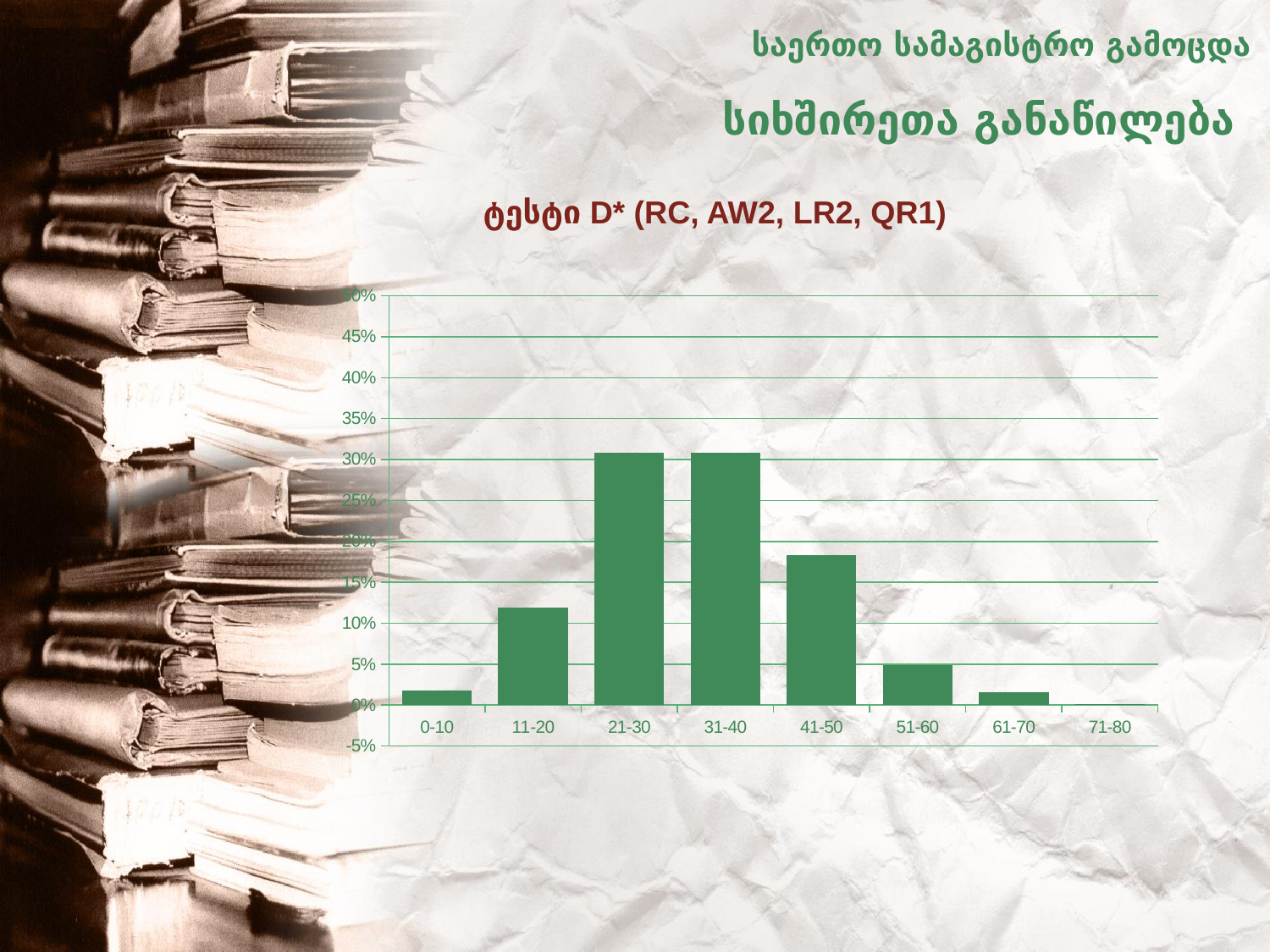
Is the value for 0-10 greater or less than 5%? less Which is larger, the value for 11-20 or the value for 41-50? 41-50 Do the values rise or fall from 31-40 to 71-80 along the x axis? fall What is the title of the chart? ტესტი D* (RC, AW2, LR2, QR1) Is the value for 11-20 greater or less than 10%? greater Is the value for 41-50 greater or less than 20%? less What kind of chart is shown on the slide? bar chart How many score-range categories are shown on the x axis? 8 Which category has the lowest value? 71-80 Which is larger, the value for 51-60 or the value for 11-20? 11-20